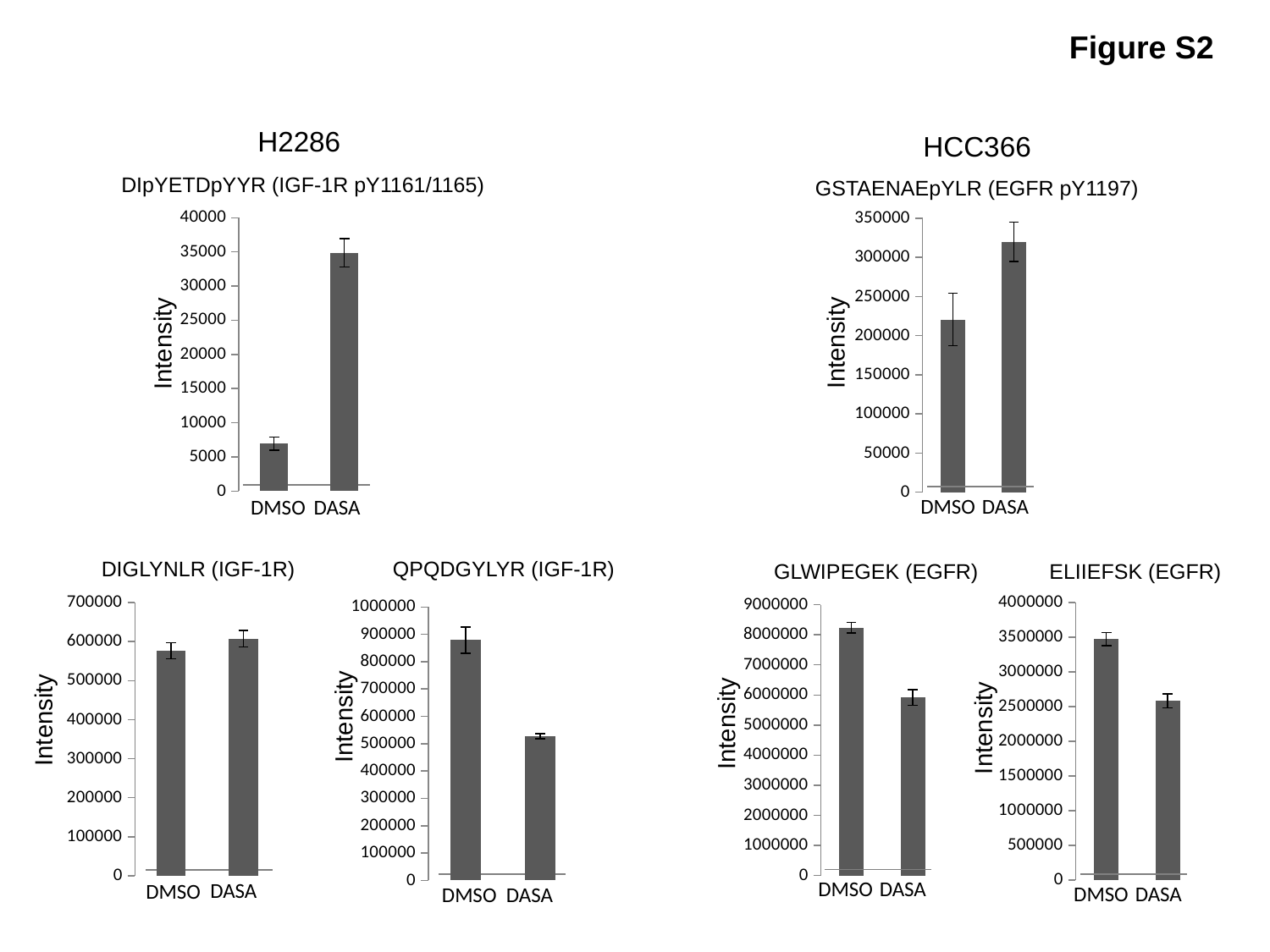
In the QPQDGYLYR (IGF-1R) chart, is the DASA value greater or less than 600000? less In the GSTAENAEpYLR (EGFR pY1197) chart, which condition has the lower intensity? DMSO In the DIpYETDpYYR (IGF-1R pY1161/1165) chart, which condition has the higher intensity, DMSO or DASA? DASA In the GLWIPEGEK (EGFR) chart, does the intensity rise or fall from DMSO to DASA? fall In the QPQDGYLYR (IGF-1R) chart, which condition has the higher intensity, DMSO or DASA? DMSO In the DIpYETDpYYR (IGF-1R pY1161/1165) chart, is the DASA value greater or less than 30000? greater What type of chart is used for GLWIPEGEK (EGFR)? bar chart In the GSTAENAEpYLR (EGFR pY1197) chart, is the DASA value greater or less than 300000? greater How many bars are plotted in the DIGLYNLR (IGF-1R) chart? 2